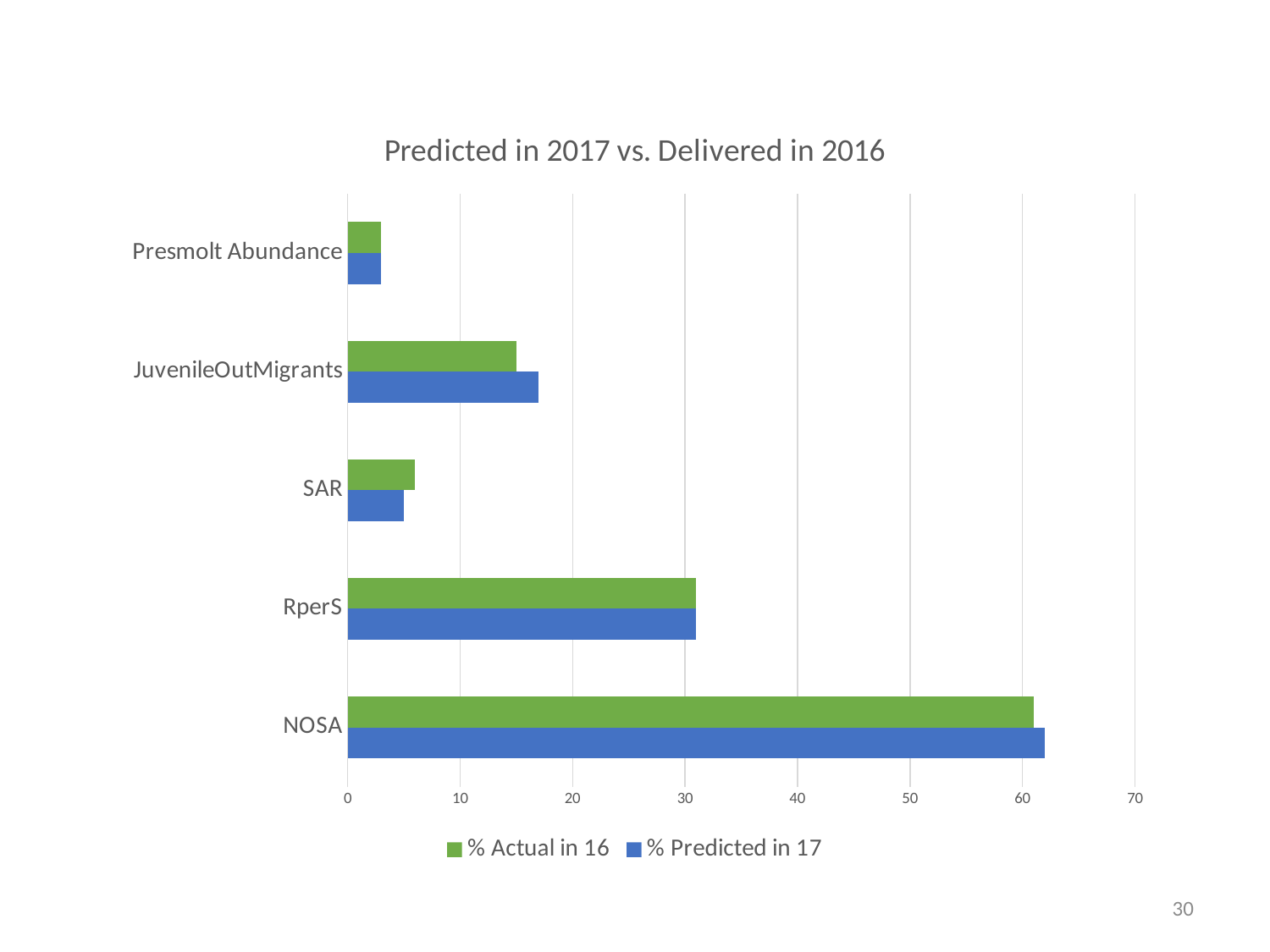
Is the value for JuvenileOutMigrants in the % Predicted in 17 series greater or less than 20? less What kind of chart is shown on the slide? bar chart Is the value for RperS in the % Predicted in 17 series greater or less than 20? greater Is the value for NOSA in the % Actual in 16 series greater or less than 50? greater What is the title of the chart? Predicted in 2017 vs. Delivered in 2016 How many categories are shown on the chart? 5 Which category has a larger % Actual in 16 value: RperS or JuvenileOutMigrants? RperS Which is larger for NOSA: % Actual in 16 or % Predicted in 17? % Predicted in 17 Which category has the highest value for % Actual in 16? NOSA How many series does the legend list? 2 Which category has the lowest value for % Predicted in 17? Presmolt Abundance